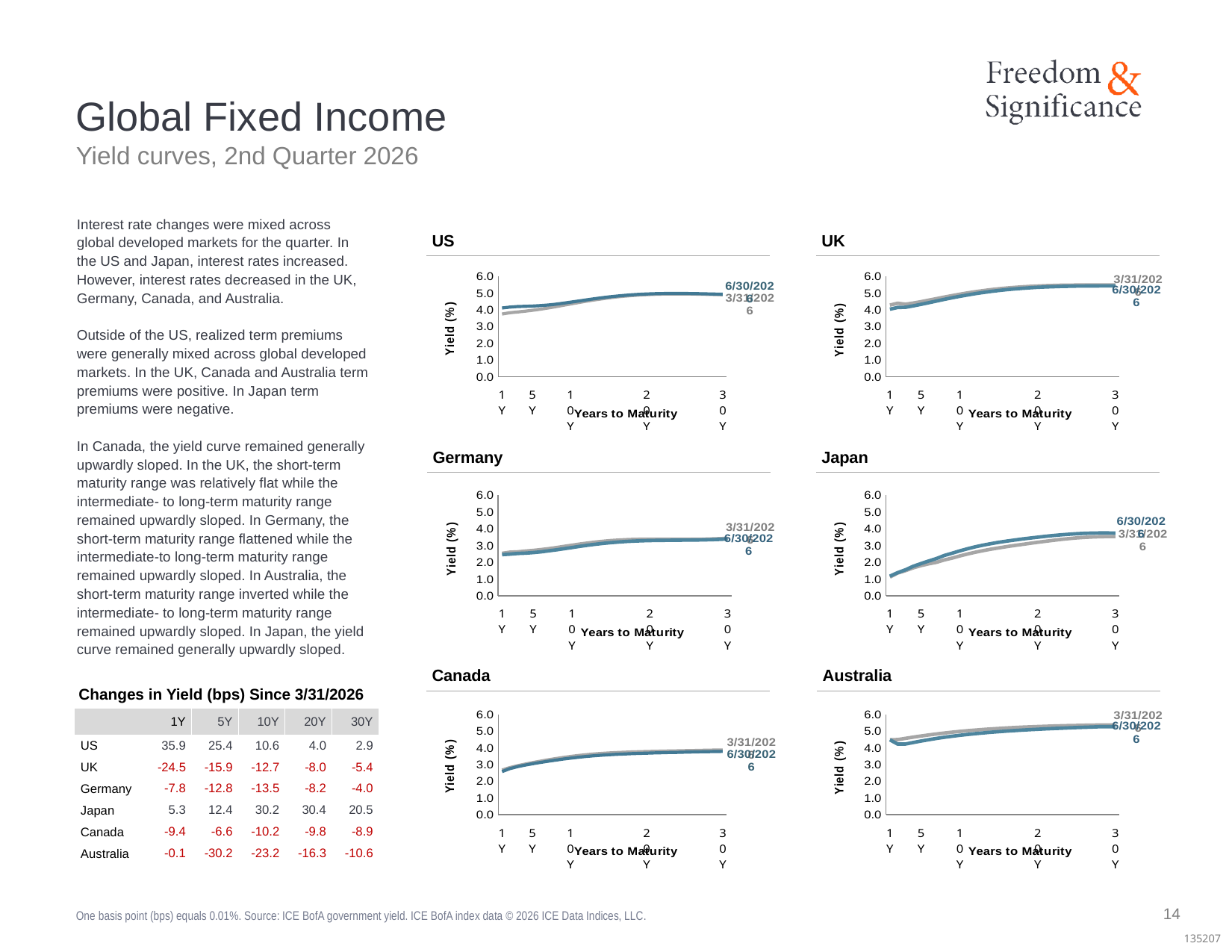
How many maturity points are plotted along the x axis of the Japan chart? 5 In the Canada chart, is the 6/30/2026 yield at 1Y greater or less than 3.0? less In the Japan chart, which series is higher at 10Y, 6/30/2026 or 3/31/2026? 6/30/2026 In the Japan chart, do yields rise or fall as years to maturity increase? rise What kind of chart is the US chart? line chart In the Japan chart, is the 6/30/2026 yield at 30Y greater or less than 3.0? greater In the UK chart, is the 6/30/2026 yield at 30Y greater or less than 5.0? greater What is the y-axis label on the Australia chart? Yield (%)